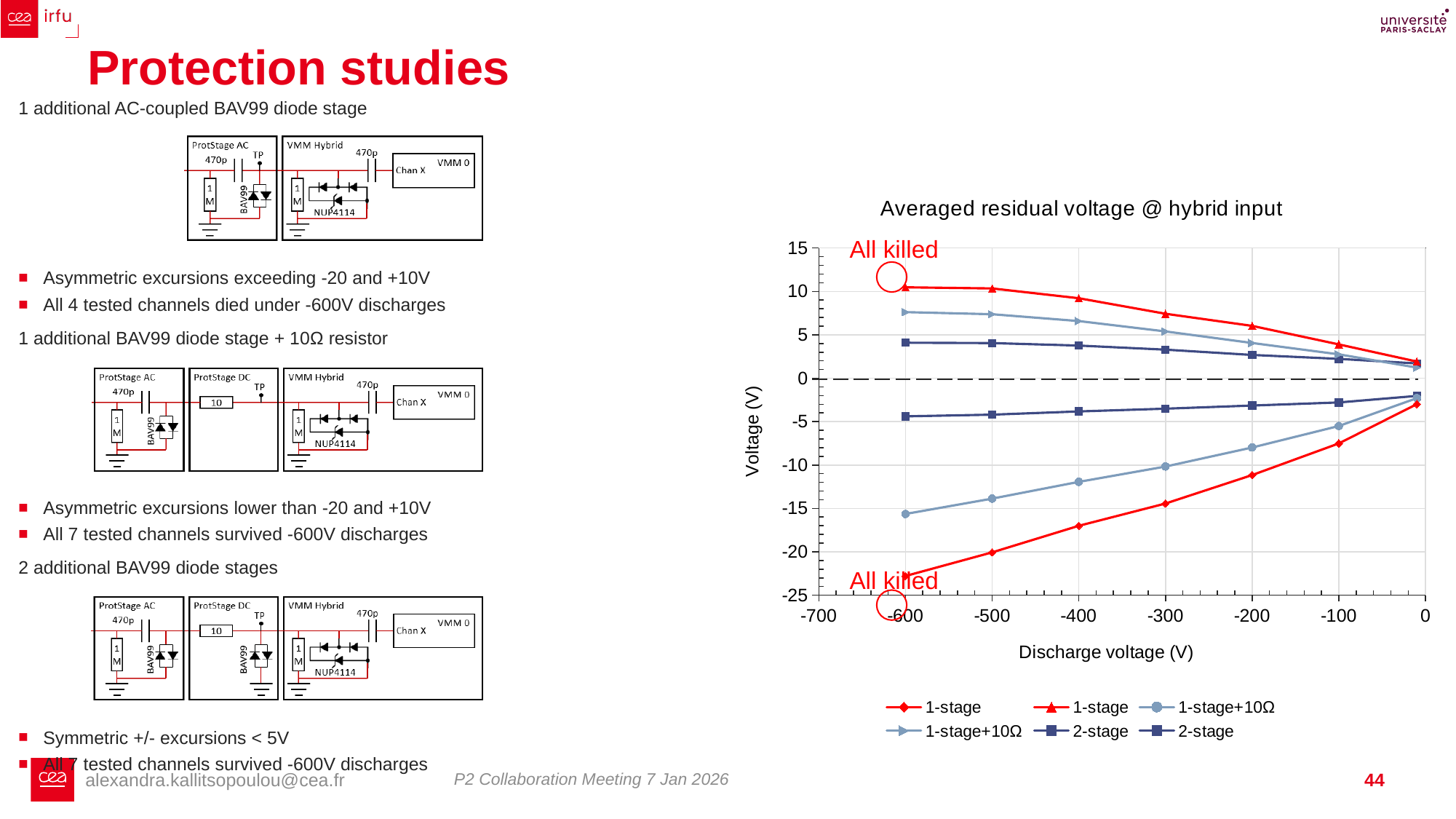
What is the label of the x axis of the chart? Discharge voltage (V) Is the value of the upper 1-stage+10Ω series (triangles) at a discharge voltage of -600 V greater or less than 5? greater Is the value of the lower 2-stage series at a discharge voltage of -600 V greater or less than -5? greater Is the value of the lower 1-stage series (red diamonds) at a discharge voltage of -600 V greater or less than -20? less Which series has the highest voltage at a discharge voltage of -600 V? 1-stage What type of chart is shown on the slide? line chart How many series does the chart legend list? 6 Does the upper 1-stage series (red triangles) rise or fall as the discharge voltage goes from -600 V to 0 V? fall At a discharge voltage of -600 V, which is larger: the upper 1-stage+10Ω series or the upper 2-stage series? 1-stage+10Ω What is the title of the chart? Averaged residual voltage @ hybrid input